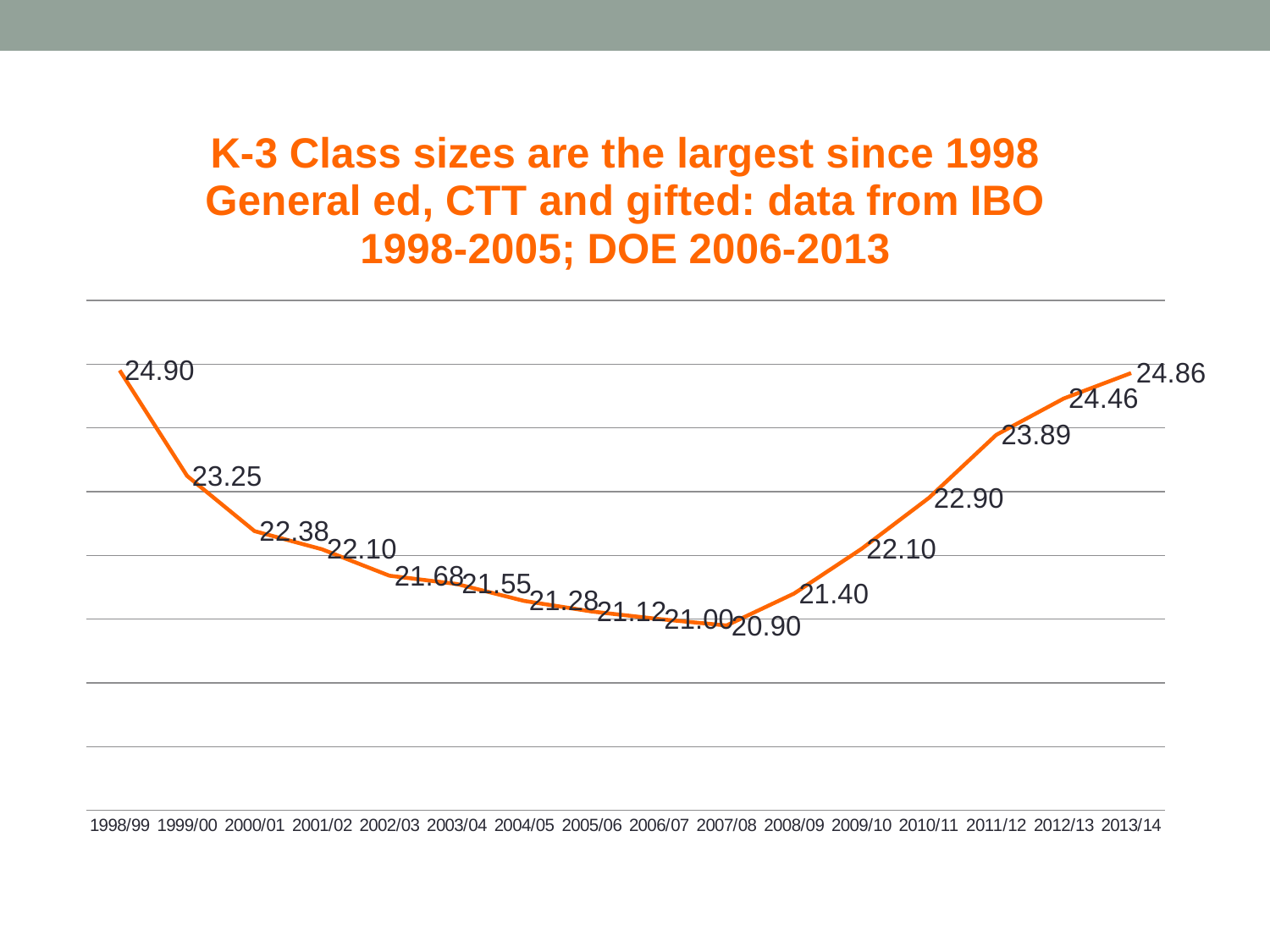
What is the difference between the values for 1998/99 and 1999/00? 1.65 What is the difference between the values for 2013/14 and 2007/08? 3.96 What kind of chart is shown on the slide? Line chart Which is larger, the value for 2012/13 or the value for 2011/12? 2012/13 Which school year has the highest plotted value? 1998/99 How many school years are plotted on the x axis? 16 What is the value plotted for 2007/08? 20.90 What is the value plotted for 2013/14? 24.86 Which school year has the lowest plotted value? 2007/08 What is the K-3 class size value for 1998/99? 24.90 What is the value plotted for 2010/11? 22.90 Do the values rise or fall from 2007/08 to 2013/14? Rise